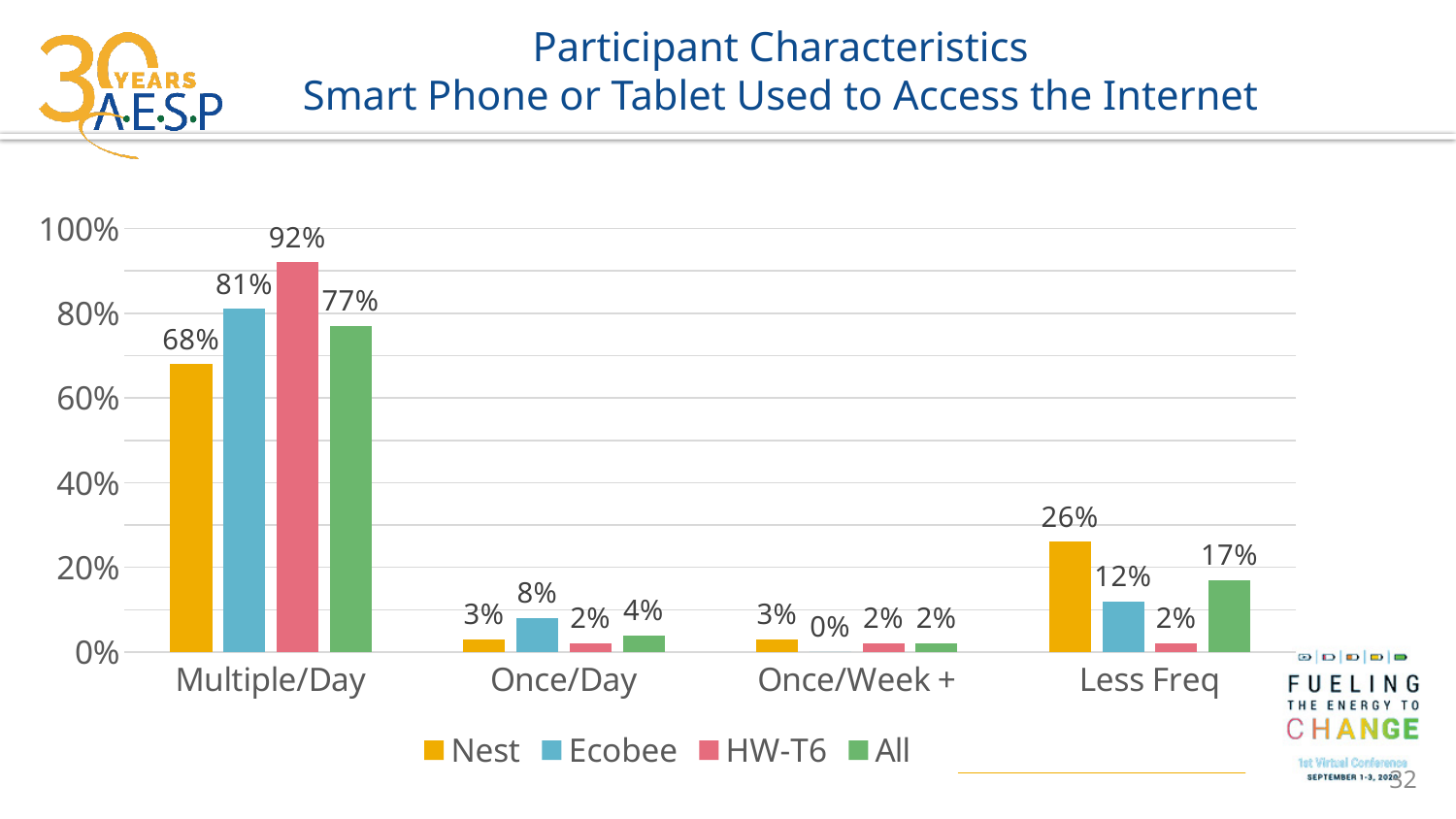
Which series has the highest value in the Multiple/Day category? HW-T6 How many series does the legend list? 4 What is the difference between the HW-T6 and Nest values in the Multiple/Day category? 24% Which is larger in the Less Freq category, Nest or Ecobee? Nest What is the value for HW-T6 in the Multiple/Day category? 92% What is the value for Nest in the Less Freq category? 26% What is the value for All in the Less Freq category? 17% What kind of chart is shown on the slide? Bar chart Which series has the lowest value in the Once/Week + category? Ecobee What colour are the bars for the Nest series? Yellow/orange What is the value for Ecobee in the Once/Day category? 8% How many categories are shown on the x axis? 4